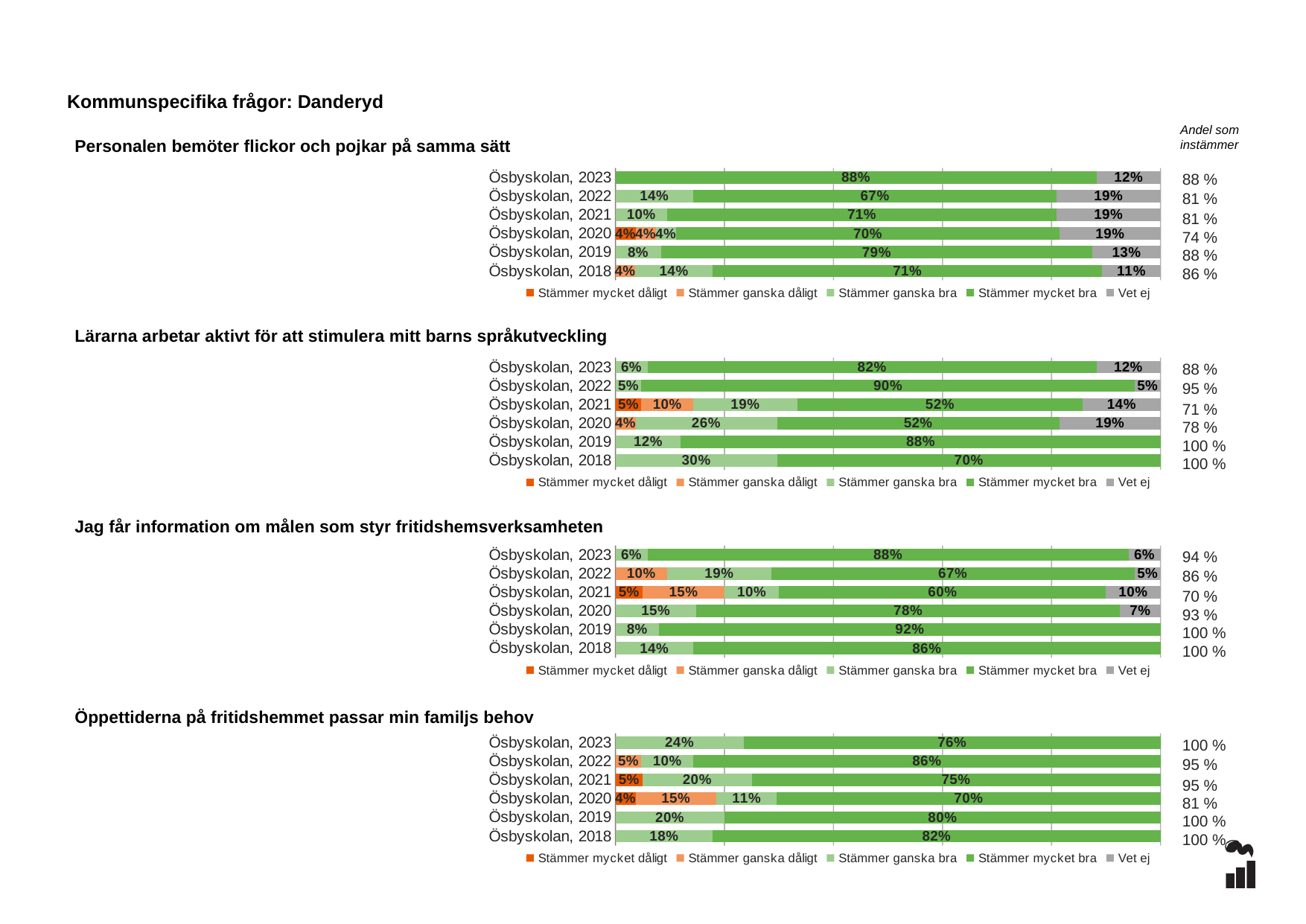
In the chart 'Jag får information om målen som styr fritidshemsverksamheten', what is the 'Stämmer ganska dåligt' value for Ösbyskolan, 2021? 15% How many bars (years) are shown in the chart 'Lärarna arbetar aktivt för att stimulera mitt barns språkutveckling'? 6 In the chart 'Öppettiderna på fritidshemmet passar min familjs behov', what is the difference between the 'Stämmer mycket bra' values for Ösbyskolan, 2023 and Ösbyskolan, 2020? 6 percentage points In the chart 'Personalen bemöter flickor och pojkar på samma sätt', what is the 'Vet ej' value for Ösbyskolan, 2019? 13% What kind of chart is used for 'Jag får information om målen som styr fritidshemsverksamheten'? Stacked bar chart In the chart 'Lärarna arbetar aktivt för att stimulera mitt barns språkutveckling', what is the 'Stämmer mycket bra' value for Ösbyskolan, 2022? 90% In the chart 'Öppettiderna på fritidshemmet passar min familjs behov', what is the 'Andel som instämmer' value for Ösbyskolan, 2020? 81 % In the chart 'Lärarna arbetar aktivt för att stimulera mitt barns språkutveckling', which year has the lowest 'Stämmer mycket bra' value? Ösbyskolan, 2021 and Ösbyskolan, 2020 (both 52%) How many series does the legend list for the chart 'Personalen bemöter flickor och pojkar på samma sätt'? 5 In the chart 'Öppettiderna på fritidshemmet passar min familjs behov', is the 'Stämmer ganska bra' value larger for Ösbyskolan, 2023 or Ösbyskolan, 2019? Ösbyskolan, 2023 In the chart 'Jag får information om målen som styr fritidshemsverksamheten', which year has the highest 'Stämmer mycket bra' value? Ösbyskolan, 2019 In the chart 'Personalen bemöter flickor och pojkar på samma sätt', what is the 'Stämmer mycket bra' value for Ösbyskolan, 2023? 88%